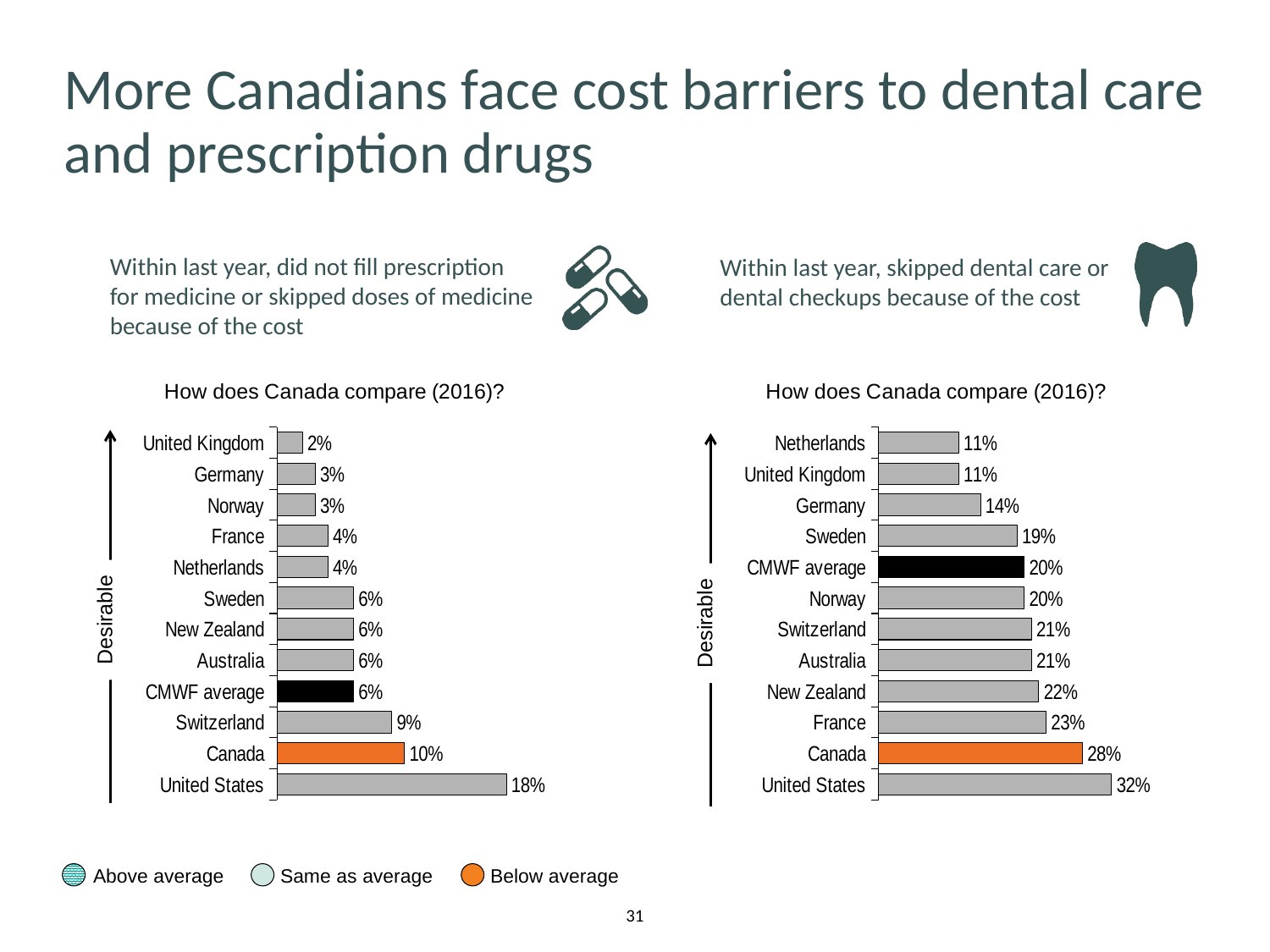
In the left chart (prescription medicine), what is the value for Canada? 10% In the left chart (prescription medicine), which country has the highest value? United States In the right chart (dental care), how many bars are shown? 12 In the right chart (dental care), which country has the highest value? United States What type of chart is used on the left side of the slide? Bar chart In the left chart (prescription medicine), what is the value for the CMWF average? 6% In the right chart (dental care), what is the difference between Canada and the CMWF average? 8% In the right chart (dental care), what is the value for Canada? 28% In the left chart (prescription medicine), what is the difference between the United States and Canada? 8% In the left chart (prescription medicine), which country has the lowest value? United Kingdom In the right chart (dental care), what is the value for Sweden? 19% In the right chart (dental care), which is larger, the value for France or the value for Germany? France